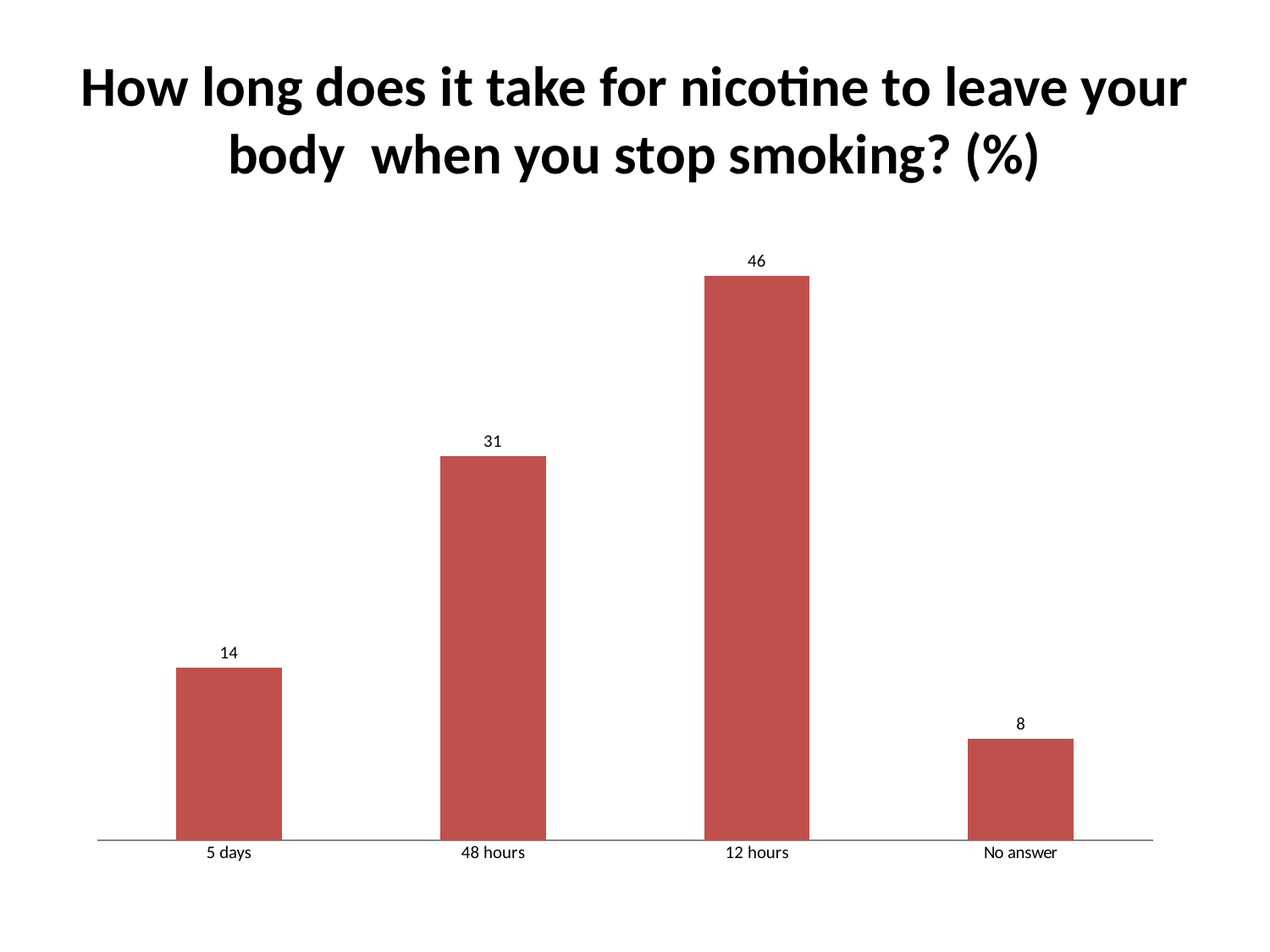
What is the value for 5 days? 14 Which category has the lowest value? No answer What is the difference between the values for 12 hours and 48 hours? 15 What kind of chart is shown on the slide? bar chart What is the value for 48 hours? 31 What is the difference between the values for 5 days and No answer? 6 What is the value for 12 hours? 46 How many categories are shown on the x axis? 4 Which category has the highest value? 12 hours Which is larger, the value for 48 hours or the value for 5 days? 48 hours What is the value for No answer? 8 What is the title of the chart? How long does it take for nicotine to leave your body when you stop smoking? (%)